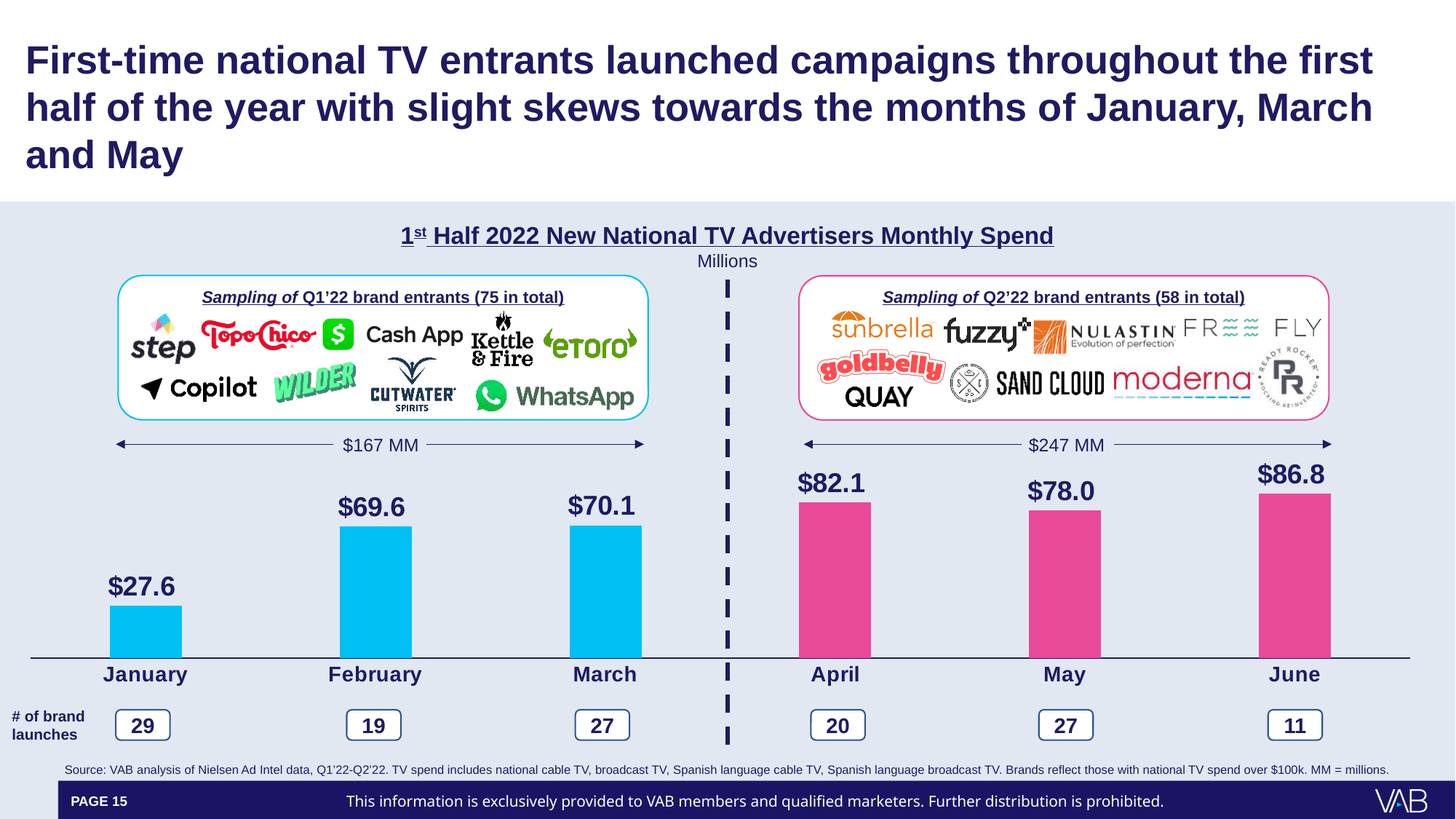
What is the monthly spend shown for May? $78.0 Which month has the lowest spend? January What is the difference in spend between June and April? $4.7 How many Q1'22 brand entrants are there in total, according to the chart? 75 What is the monthly spend shown for January? $27.6 Which month has the larger spend, February or April? April What kind of chart is shown on the slide? Bar chart Which month has the highest spend? June What is the title of the chart? 1st Half 2022 New National TV Advertisers Monthly Spend What is the total spend shown for the Q2'22 months (April through June)? $247 MM How many months are plotted on the chart? 6 How many brand launches are listed for February? 19